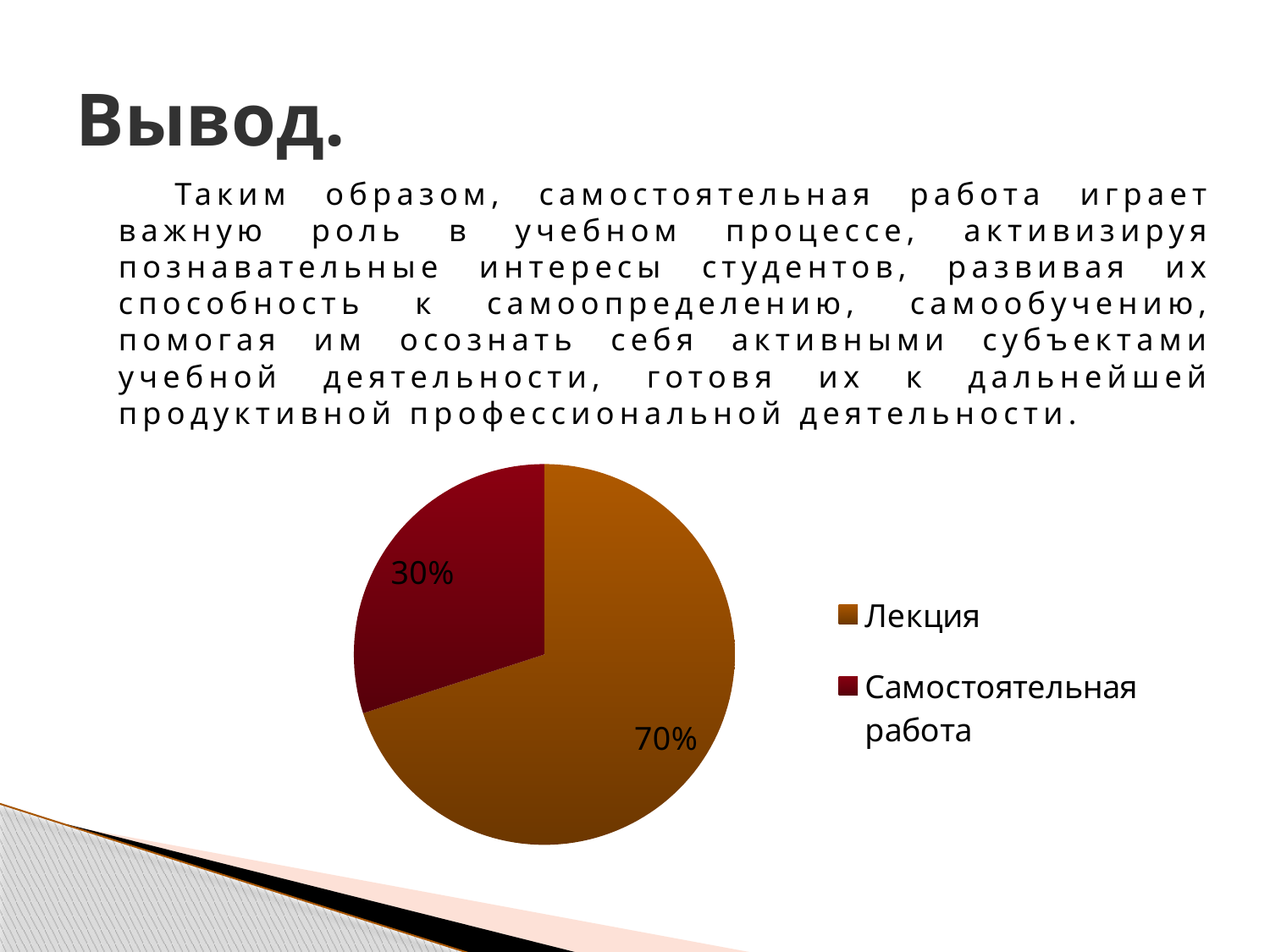
What is the difference between the shares of Лекция and Самостоятельная работа? 40% Which category has the smallest slice of the pie? Самостоятельная работа Which is larger, the slice for Лекция or the slice for Самостоятельная работа? Лекция What kind of chart is shown on the slide? pie chart How many slices does the pie chart have? 2 How many entries does the legend list? 2 What share of the pie does Самостоятельная работа take? 30% What colour is the slice for Самостоятельная работа? dark red What share of the pie does Лекция take? 70% Which category has the largest slice of the pie? Лекция What colour is the slice for Лекция? brown